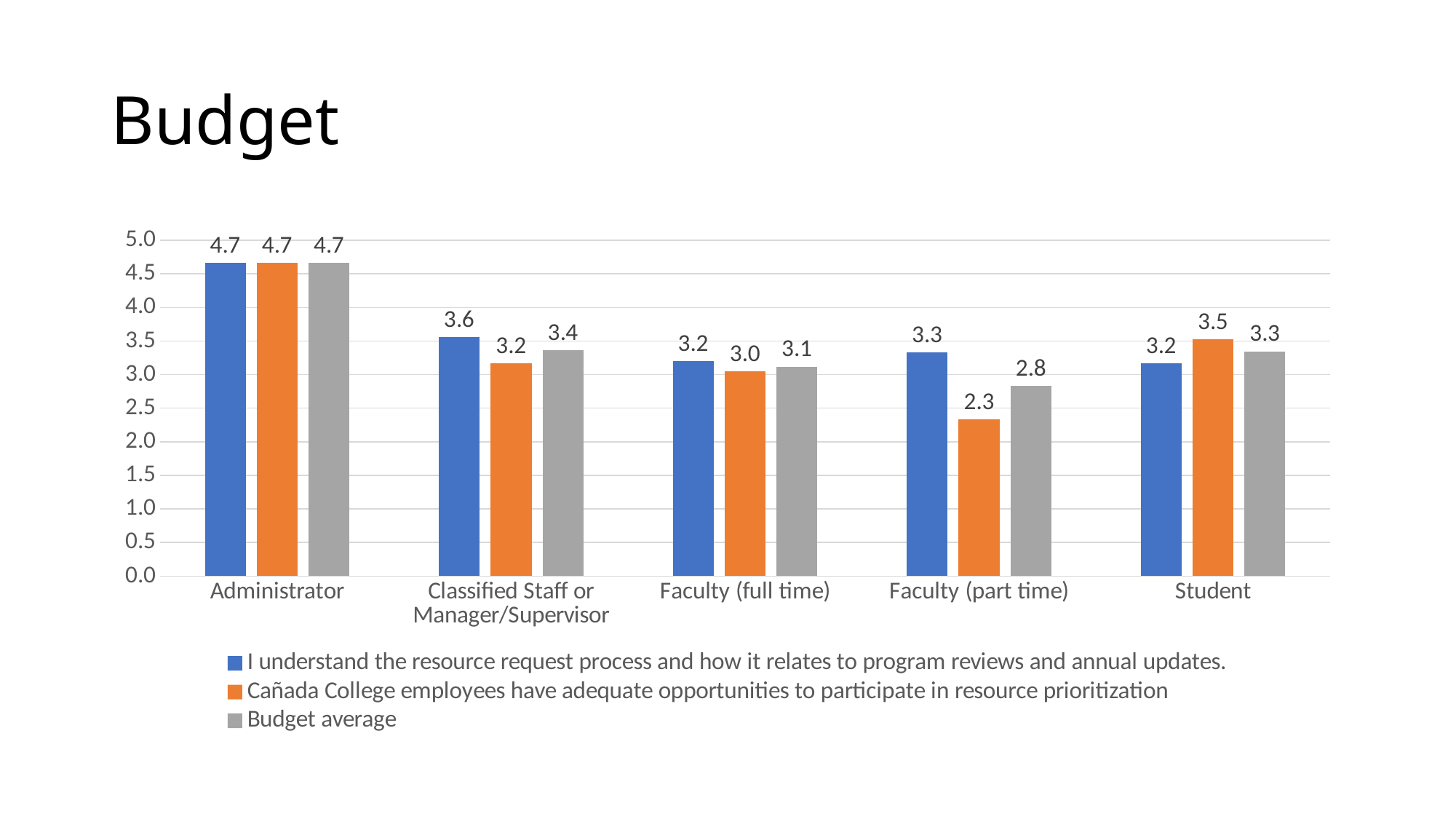
What is the value for Student on the series 'Cañada College employees have adequate opportunities to participate in resource prioritization'? 3.5 What is the value for Classified Staff or Manager/Supervisor on the series 'I understand the resource request process and how it relates to program reviews and annual updates.'? 3.6 How many categories are shown on the x axis? 5 What kind of chart is shown on the slide? Bar chart Which category has the highest Budget average? Administrator Which category has the lowest value on the series 'Cañada College employees have adequate opportunities to participate in resource prioritization'? Faculty (part time) Is the Budget average for Faculty (part time) greater or less than 3.0? less What is the Budget average value for Faculty (part time)? 2.8 How many series does the legend list? 3 What is the difference between the Administrator and Faculty (part time) values on the series 'Cañada College employees have adequate opportunities to participate in resource prioritization'? 2.4 What is the title of the slide? Budget For Faculty (part time), which is larger: the 'I understand the resource request process...' value or the 'Cañada College employees have adequate opportunities...' value? I understand the resource request process and how it relates to program reviews and annual updates.